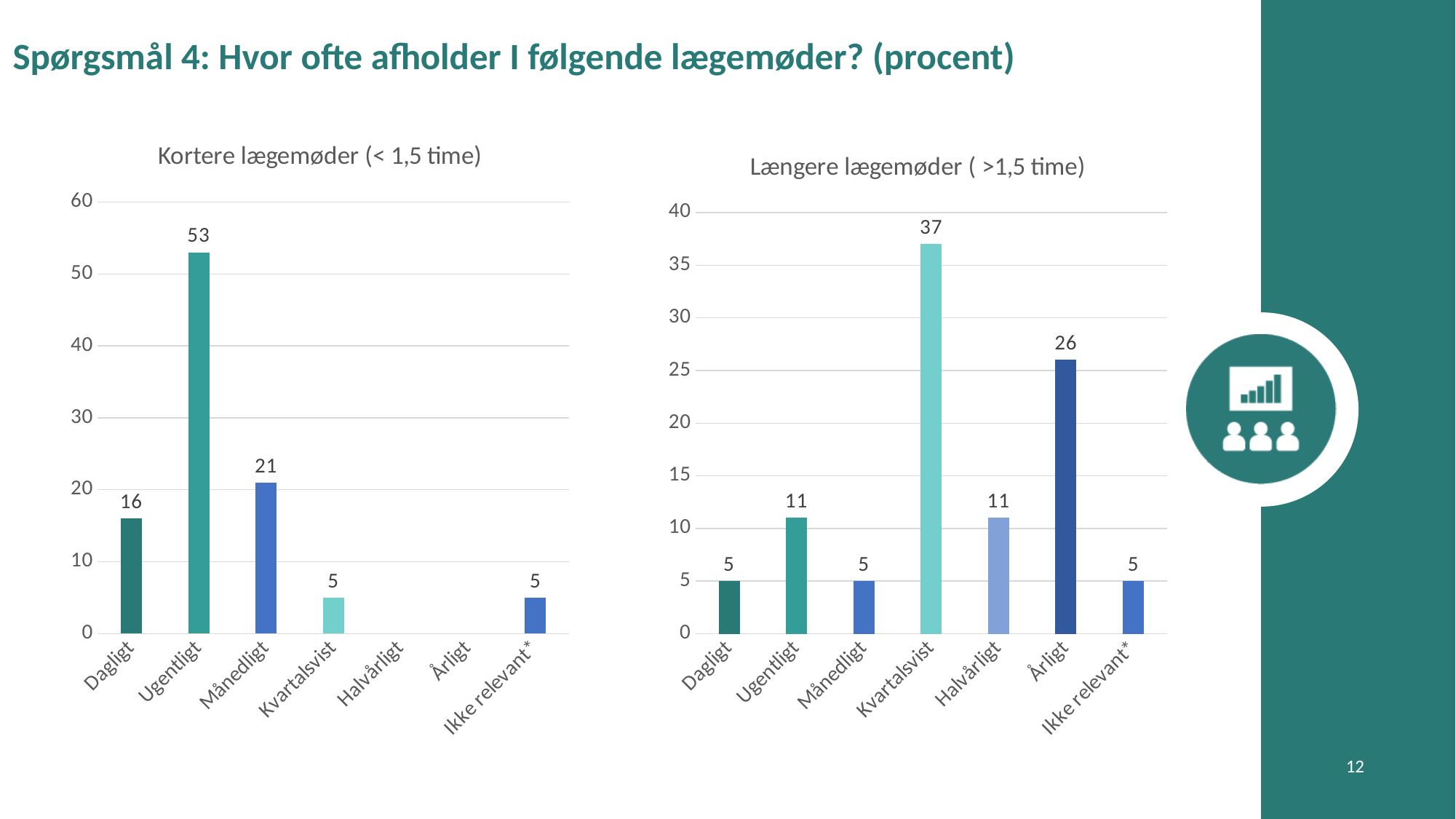
In the chart titled "Længere lægemøder ( >1,5 time)", which category has the highest value? Kvartalsvist In the chart titled "Længere lægemøder ( >1,5 time)", what is the difference between the values for Kvartalsvist and Årligt? 11 In the chart titled "Kortere lægemøder (< 1,5 time)", which category has the highest value? Ugentligt In the chart titled "Kortere lægemøder (< 1,5 time)", what is the value for Ugentligt? 53 In the chart titled "Kortere lægemøder (< 1,5 time)", what is the value for Månedligt? 21 In the chart titled "Længere lægemøder ( >1,5 time)", which is larger, the value for Ugentligt or the value for Årligt? Årligt In the chart titled "Længere lægemøder ( >1,5 time)", what is the value for Årligt? 26 In the chart titled "Kortere lægemøder (< 1,5 time)", what is the difference between the values for Ugentligt and Dagligt? 37 What kind of chart is the chart titled "Kortere lægemøder (< 1,5 time)"? Bar chart What is the title of the chart on the right side of the slide? Længere lægemøder ( >1,5 time) In the chart titled "Kortere lægemøder (< 1,5 time)", how many categories are shown on the x axis? 7 In the chart titled "Længere lægemøder ( >1,5 time)", what is the value for Kvartalsvist? 37